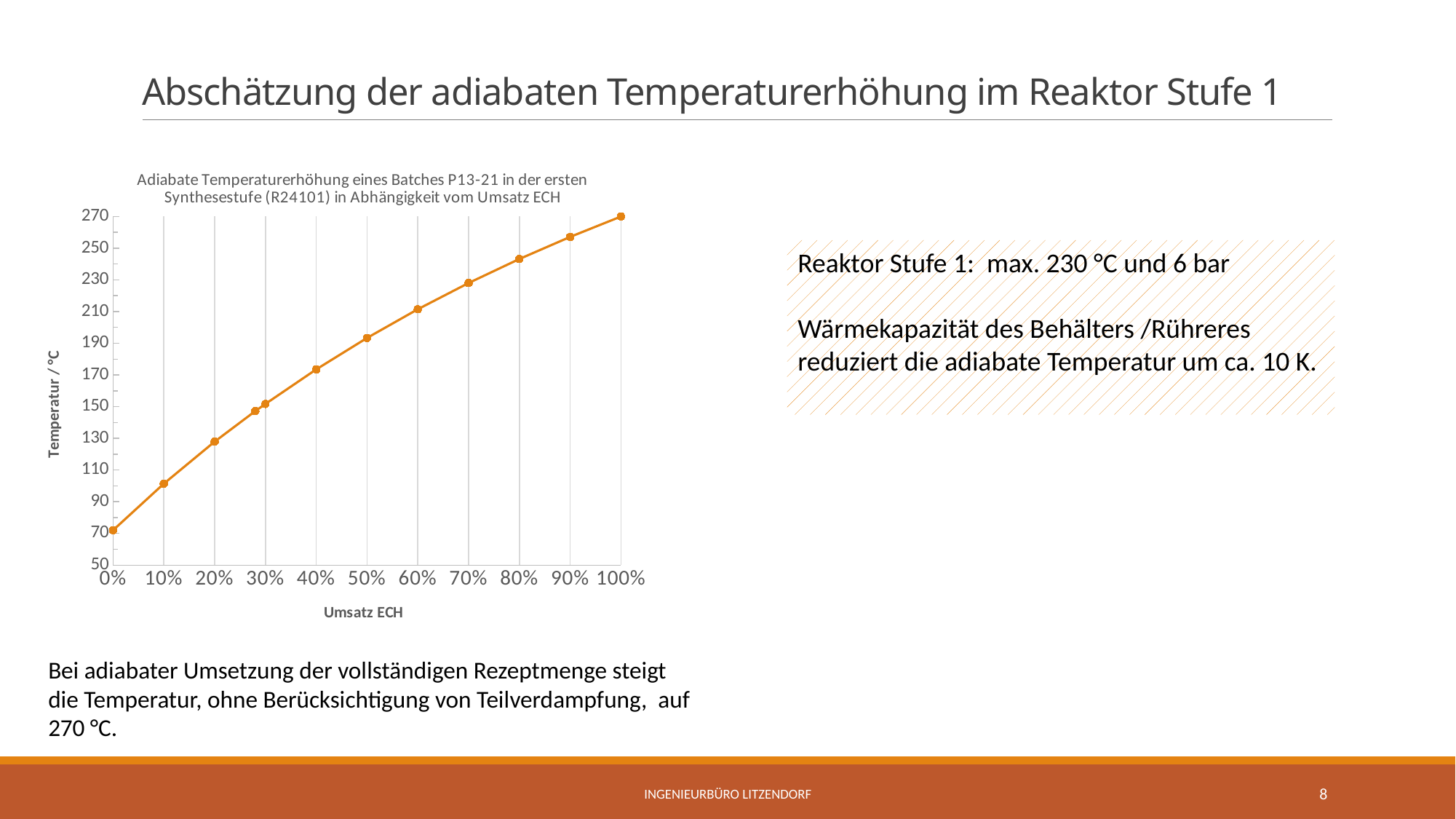
Is the temperature at 90% Umsatz ECH greater or less than 250? greater At which Umsatz ECH value is the temperature highest? 100% What is the title of the x axis of the chart? Umsatz ECH What kind of chart is shown on the slide? line chart Which is higher, the temperature at 80% or at 60% Umsatz ECH? 80% At which Umsatz ECH value is the temperature lowest? 0% What is the temperature at 100% Umsatz ECH? 270 Is the temperature at 10% Umsatz ECH greater or less than 90? greater Does the temperature rise or fall as Umsatz ECH increases from 0% to 100%? rises Is the temperature at 80% Umsatz ECH greater or less than 250? less